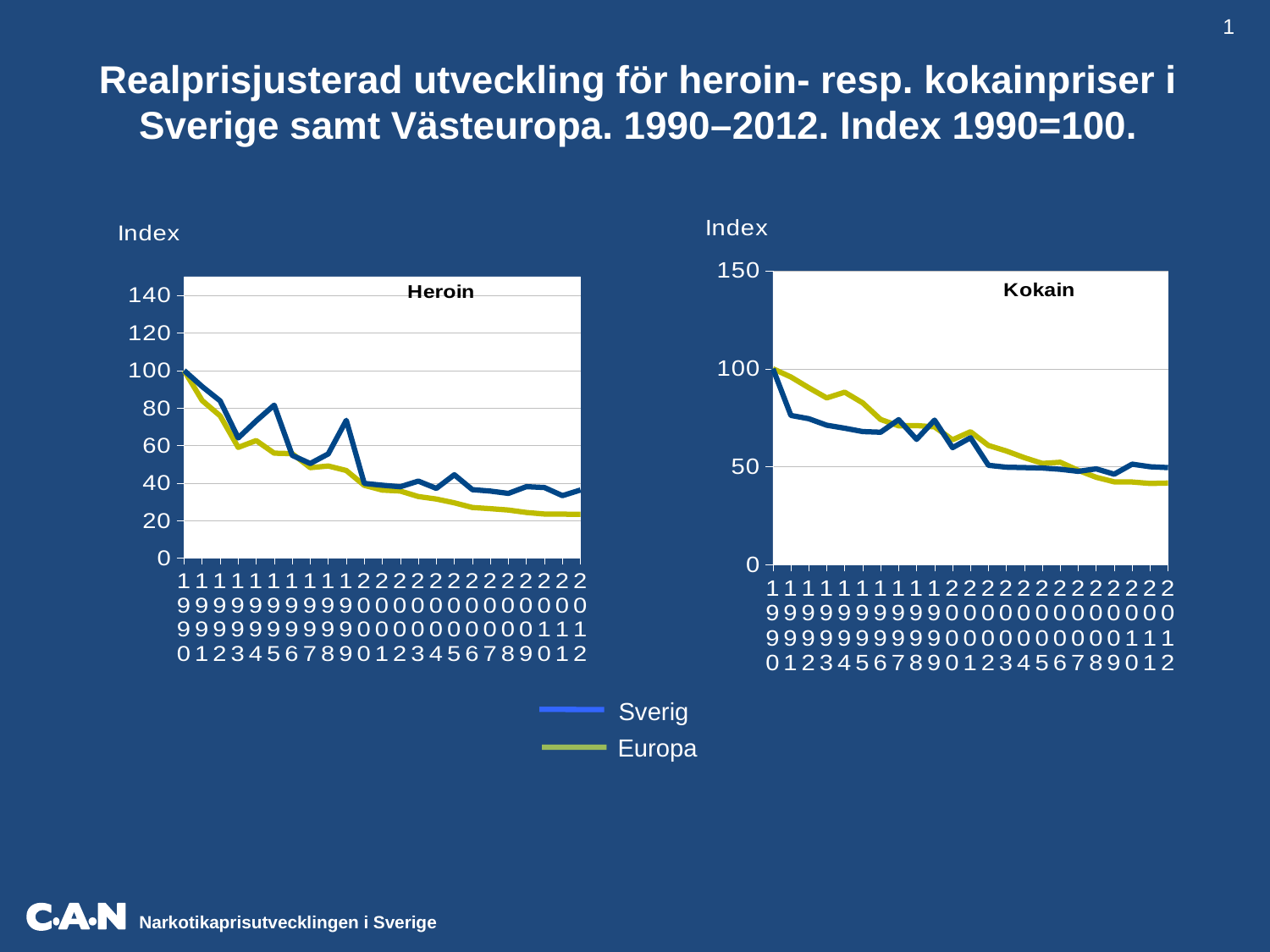
In the Kokain chart, is the value for Europa in 1991 greater or less than 50? greater In the Heroin chart, is the value for Sverige in 1997 greater or less than 60? less In the Heroin chart, which series has the higher value in 2012, Sverige or Europa? Sverige In the Heroin chart, what is the index value for Sverige in 1990? 100 In the Kokain chart, what is the index value for Europa in 1990? 100 In the Heroin chart, do the Europa values rise or fall from 1990 to 2012? fall In the Kokain chart, do the Sverige values rise or fall from 1990 to 2012? fall How many series does the legend list? 2 In the Heroin chart, is the value for Europa in 2012 greater or less than 40? less What are the two entries in the legend? Sverig, Europa What kind of chart is the Heroin chart on the left? line chart In the Heroin chart, how many years are plotted along the x axis? 23